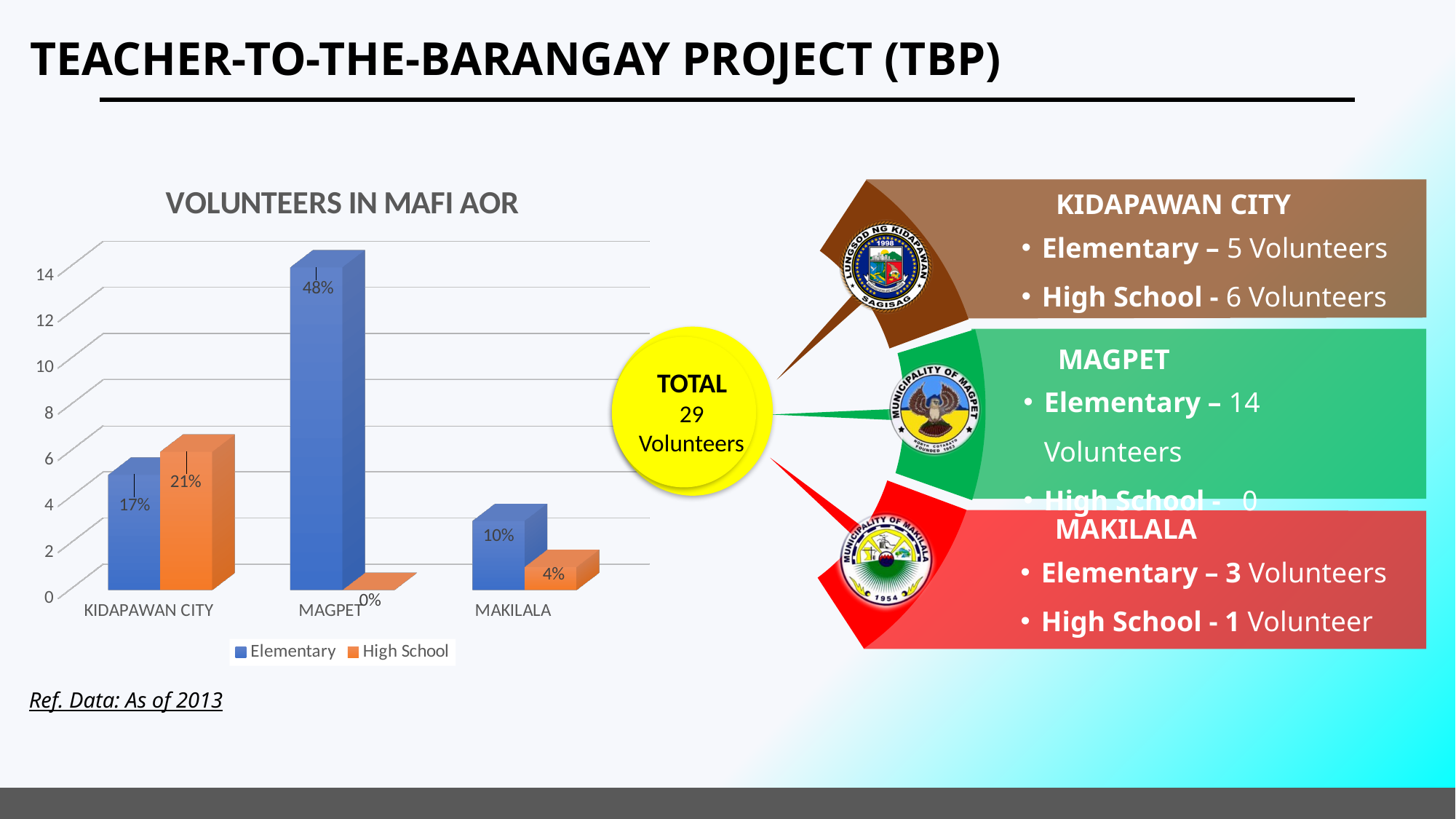
Is the Elementary bar for MAGPET greater or less than 12 on the axis? greater What is the data label on the High School bar for MAGPET? 0% What kind of chart is shown on the slide? bar chart What is the title of the chart? VOLUNTEERS IN MAFI AOR Which category has the lowest High School bar? MAGPET How many series does the chart legend list? 2 How many categories are shown on the x axis of the chart? 3 Which category has the highest Elementary bar? MAGPET What is the data label on the High School bar for KIDAPAWAN CITY? 21% What is the data label on the Elementary bar for MAKILALA? 10% For KIDAPAWAN CITY, which bar is taller: Elementary or High School? High School What is the data label on the Elementary bar for MAGPET? 48%